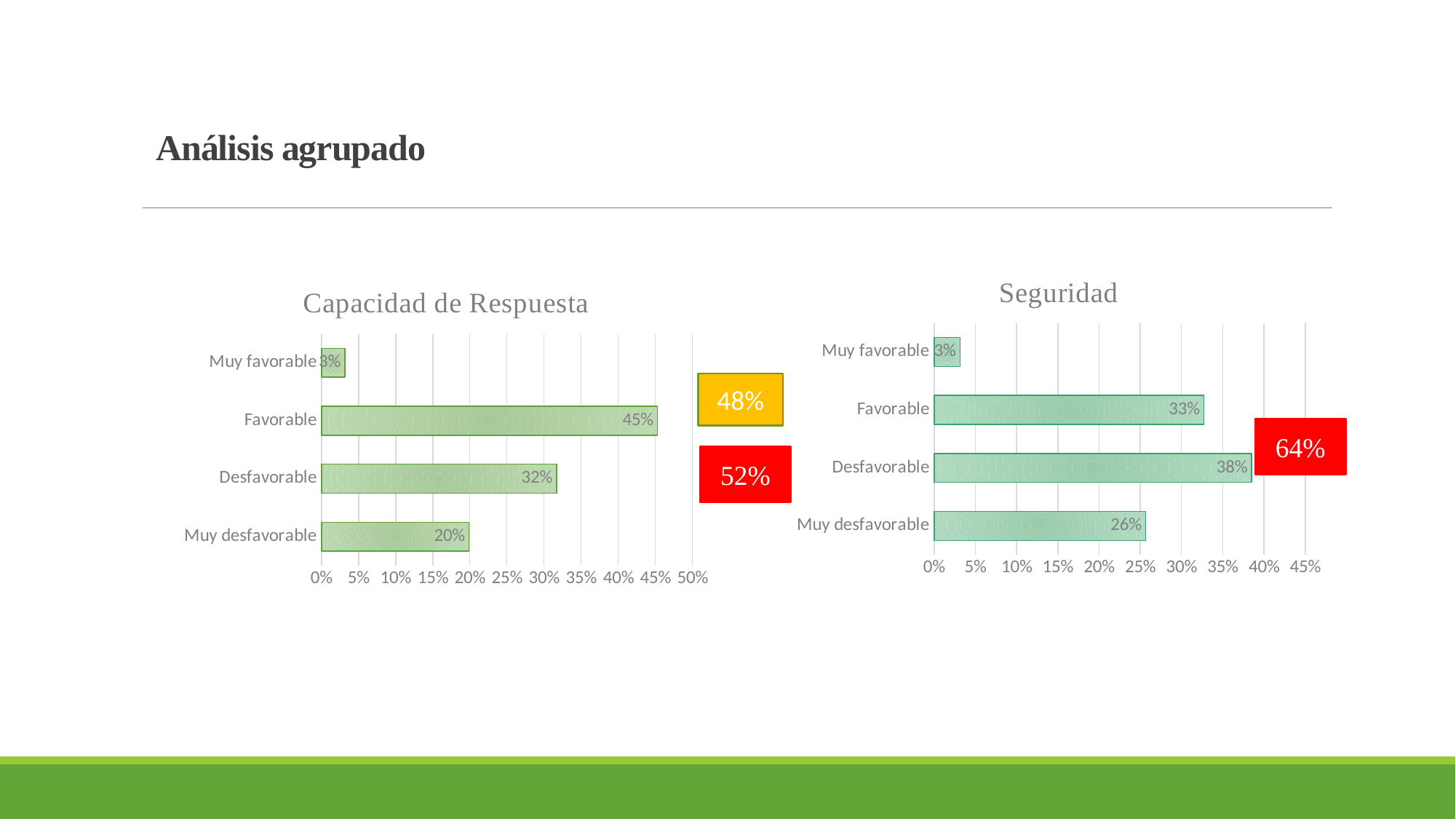
In the 'Seguridad' chart, which category has the highest value? Desfavorable In the 'Seguridad' chart, which category has the lowest value? Muy favorable In the 'Seguridad' chart, what is the difference between Desfavorable and Muy desfavorable? 12% What kind of chart is the 'Seguridad' chart? Bar chart In the 'Capacidad de Respuesta' chart, what is the difference between Favorable and Desfavorable? 13% In the 'Capacidad de Respuesta' chart, what is the value for Favorable? 45% In the 'Seguridad' chart, what is the value for Muy favorable? 3% In the 'Capacidad de Respuesta' chart, which category has the highest value? Favorable How many categories does the 'Capacidad de Respuesta' chart show? 4 In the 'Seguridad' chart, what is the value for Desfavorable? 38% In the 'Capacidad de Respuesta' chart, what is the value for Muy desfavorable? 20% In the 'Seguridad' chart, which is larger, Favorable or Desfavorable? Desfavorable